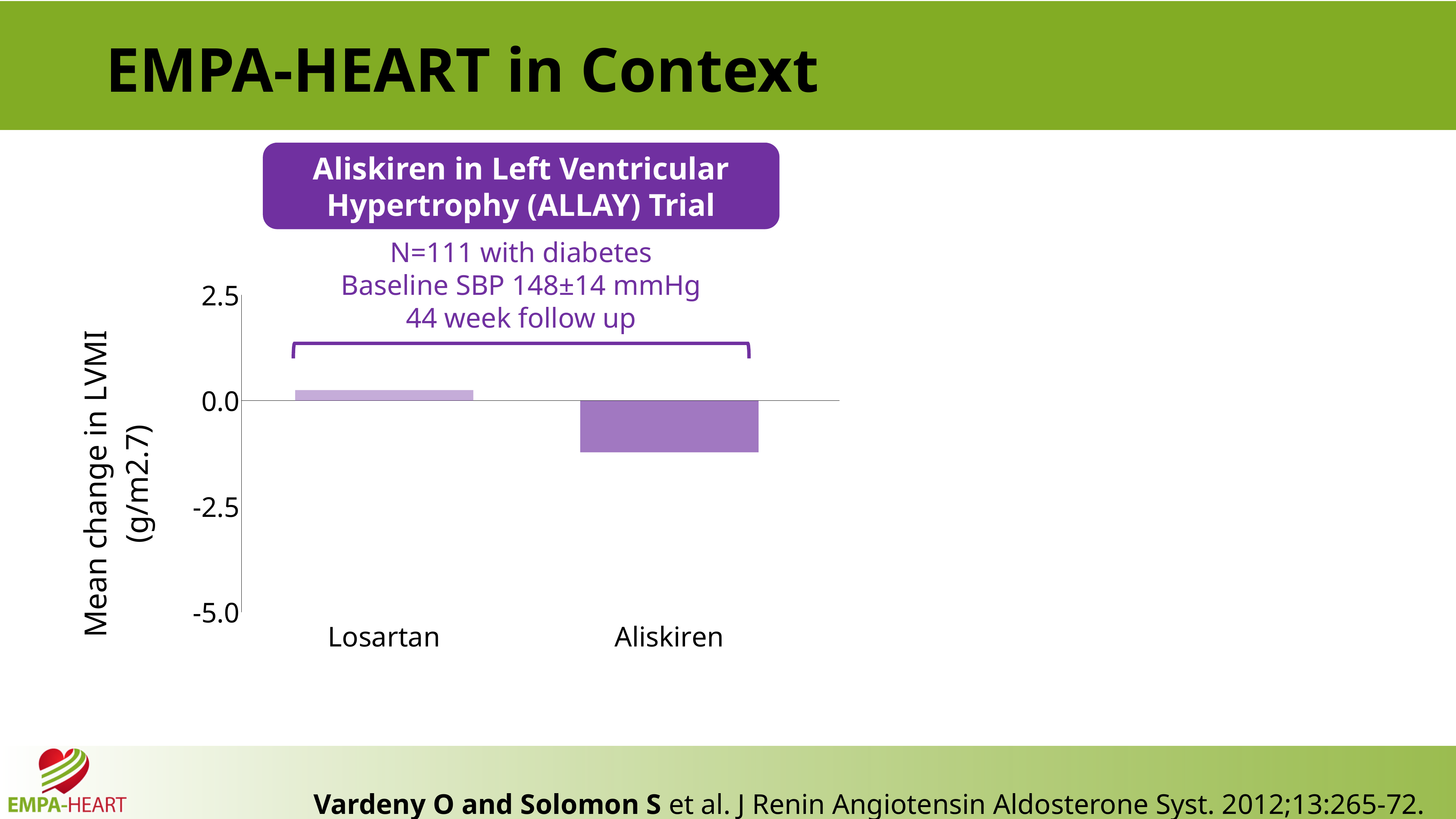
Is the value for Losartan greater or less than 2.5? less Which category has the lowest mean change in LVMI? Aliskiren What is the label of the y axis of the chart? Mean change in LVMI (g/m2.7) What is the title shown above the chart? Aliskiren in Left Ventricular Hypertrophy (ALLAY) Trial How many categories are plotted on the x axis of the chart? 2 Which has the larger mean change in LVMI, Losartan or Aliskiren? Losartan Is the value for Aliskiren greater or less than 0.0? less Which category has the highest mean change in LVMI? Losartan Is the value for Aliskiren greater or less than -2.5? greater What kind of chart is shown on the slide? bar chart